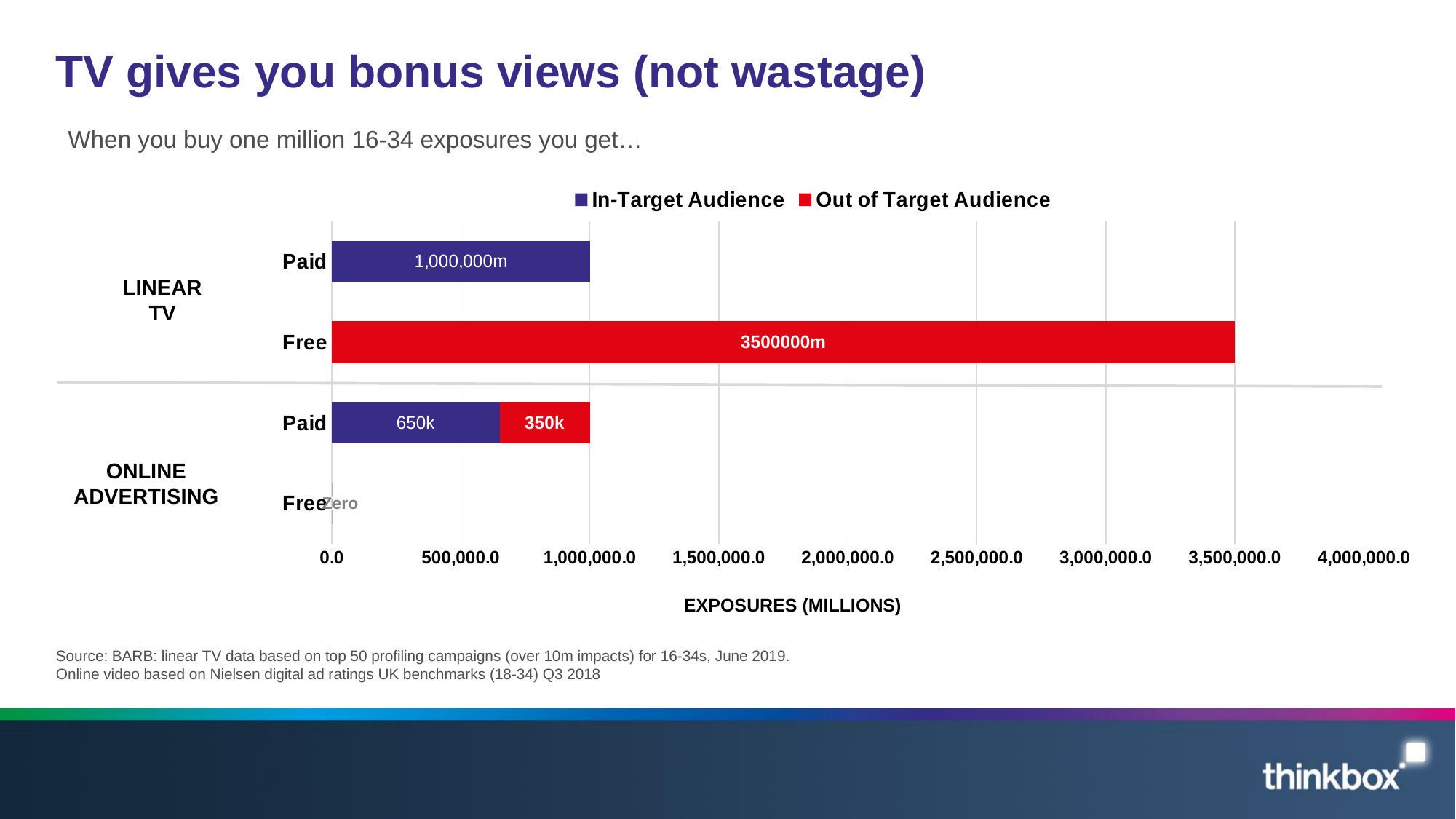
What is the data label on the In-Target Audience bar for Linear TV Paid? 1,000,000m Is the Linear TV Free bar greater or less than 3,000,000.0 on the x axis? greater Which colour represents the Out of Target Audience series in the legend? red What kind of chart is shown on the slide? bar chart What is the x-axis title of the chart? EXPOSURES (MILLIONS) What is the In-Target Audience value for Online Advertising Paid? 650k What is the data label on the Out of Target Audience bar for Linear TV Free? 3500000m What label is shown for Online Advertising Free? Zero Which bar is the longest in the chart? Linear TV Free How many series does the legend list? 2 Which is larger for Online Advertising Paid: the In-Target Audience value or the Out of Target Audience value? In-Target Audience What is the Out of Target Audience value for Online Advertising Paid? 350k